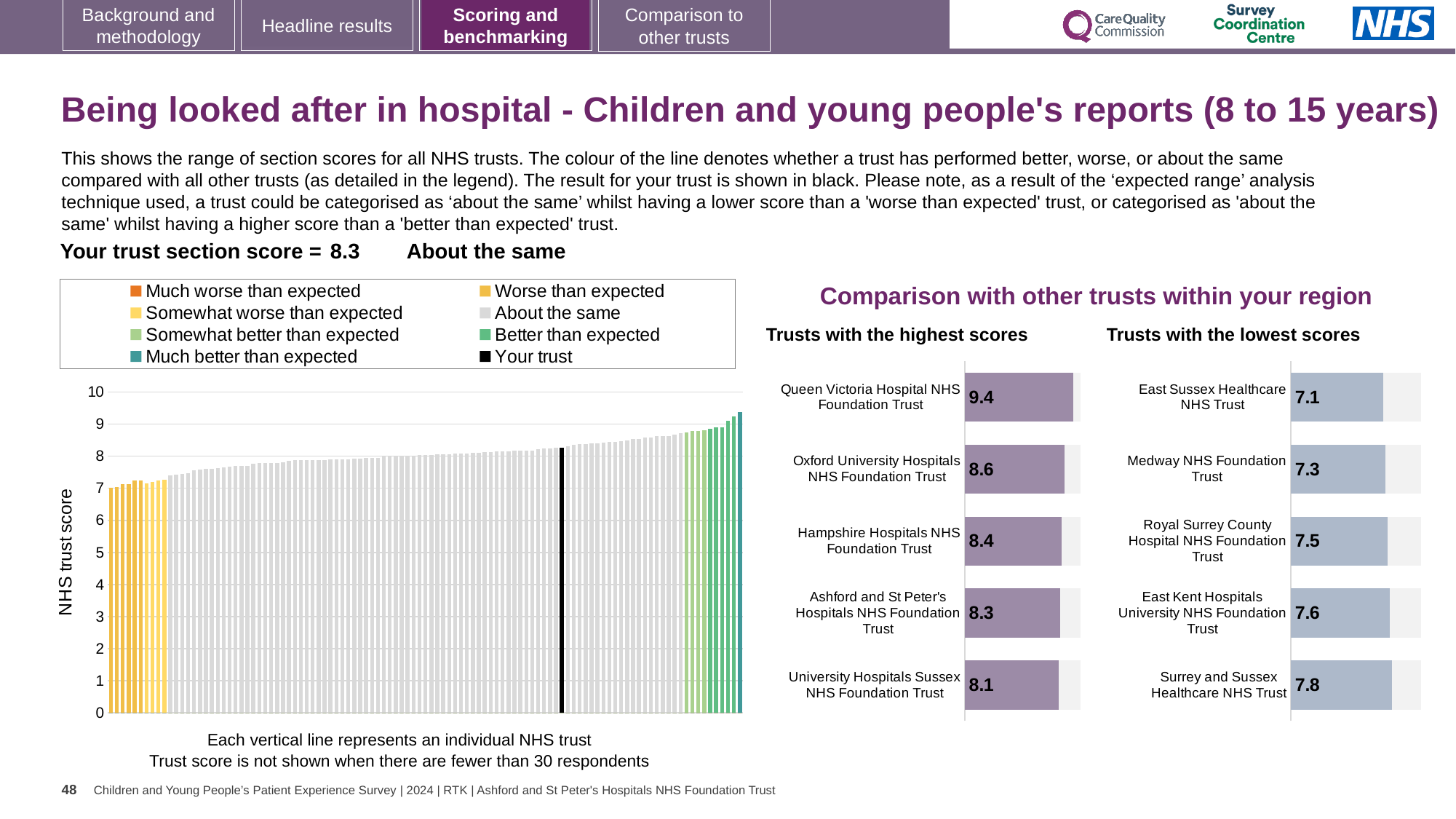
In the 'Trusts with the highest scores' chart, what is the score for Hampshire Hospitals NHS Foundation Trust? 8.4 What kind of chart is the NHS trust score chart on the left of the slide? Bar chart How many entries does the legend of the NHS trust score chart list? 8 How many trusts are shown in the 'Trusts with the lowest scores' chart? 5 Which has the higher score: Oxford University Hospitals NHS Foundation Trust in the highest scores chart or Royal Surrey County Hospital NHS Foundation Trust in the lowest scores chart? Oxford University Hospitals NHS Foundation Trust In the 'Trusts with the lowest scores' chart, which trust has the lowest score? East Sussex Healthcare NHS Trust In the 'Trusts with the highest scores' chart, what is the difference between the scores of Queen Victoria Hospital NHS Foundation Trust and University Hospitals Sussex NHS Foundation Trust? 1.3 In the 'Trusts with the lowest scores' chart, what is the score for Medway NHS Foundation Trust? 7.3 In the 'Trusts with the highest scores' chart, what is the score for Queen Victoria Hospital NHS Foundation Trust? 9.4 In the NHS trust score chart on the left, do the trust scores rise or fall from left to right? Rise In the 'Trusts with the highest scores' chart, which trust has the highest score? Queen Victoria Hospital NHS Foundation Trust In the 'Trusts with the lowest scores' chart, what is the difference between the scores of Surrey and Sussex Healthcare NHS Trust and East Sussex Healthcare NHS Trust? 0.7